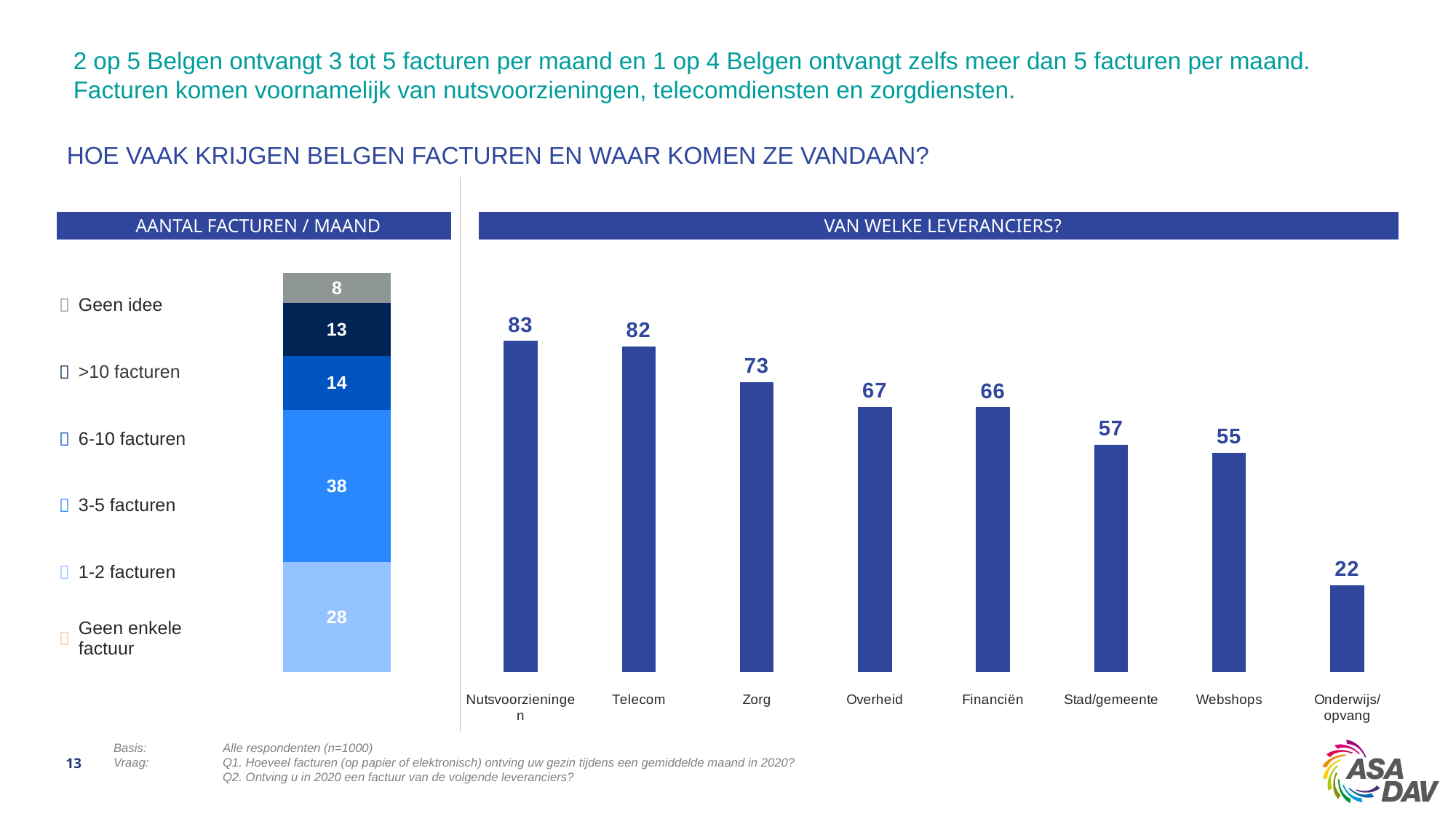
In the 'VAN WELKE LEVERANCIERS?' chart, what is the value for Webshops? 55 How many categories are shown in the 'VAN WELKE LEVERANCIERS?' chart? 8 How many entries does the legend of the 'AANTAL FACTUREN / MAAND' chart list? 6 In the 'VAN WELKE LEVERANCIERS?' chart, which category has the highest value? Nutsvoorzieningen In the 'VAN WELKE LEVERANCIERS?' chart, which is larger: Stad/gemeente or Webshops? Stad/gemeente What kind of chart is the 'VAN WELKE LEVERANCIERS?' chart? Bar chart In the 'VAN WELKE LEVERANCIERS?' chart, do the values rise or fall from left to right? Fall In the 'AANTAL FACTUREN / MAAND' chart, what is the value for '3-5 facturen'? 38 In the 'VAN WELKE LEVERANCIERS?' chart, what is the value for Telecom? 82 In the 'VAN WELKE LEVERANCIERS?' chart, which category has the lowest value? Onderwijs/opvang In the 'AANTAL FACTUREN / MAAND' chart, what is the value for 'Geen idee'? 8 In the 'VAN WELKE LEVERANCIERS?' chart, what is the difference between the values for Zorg and Overheid? 6